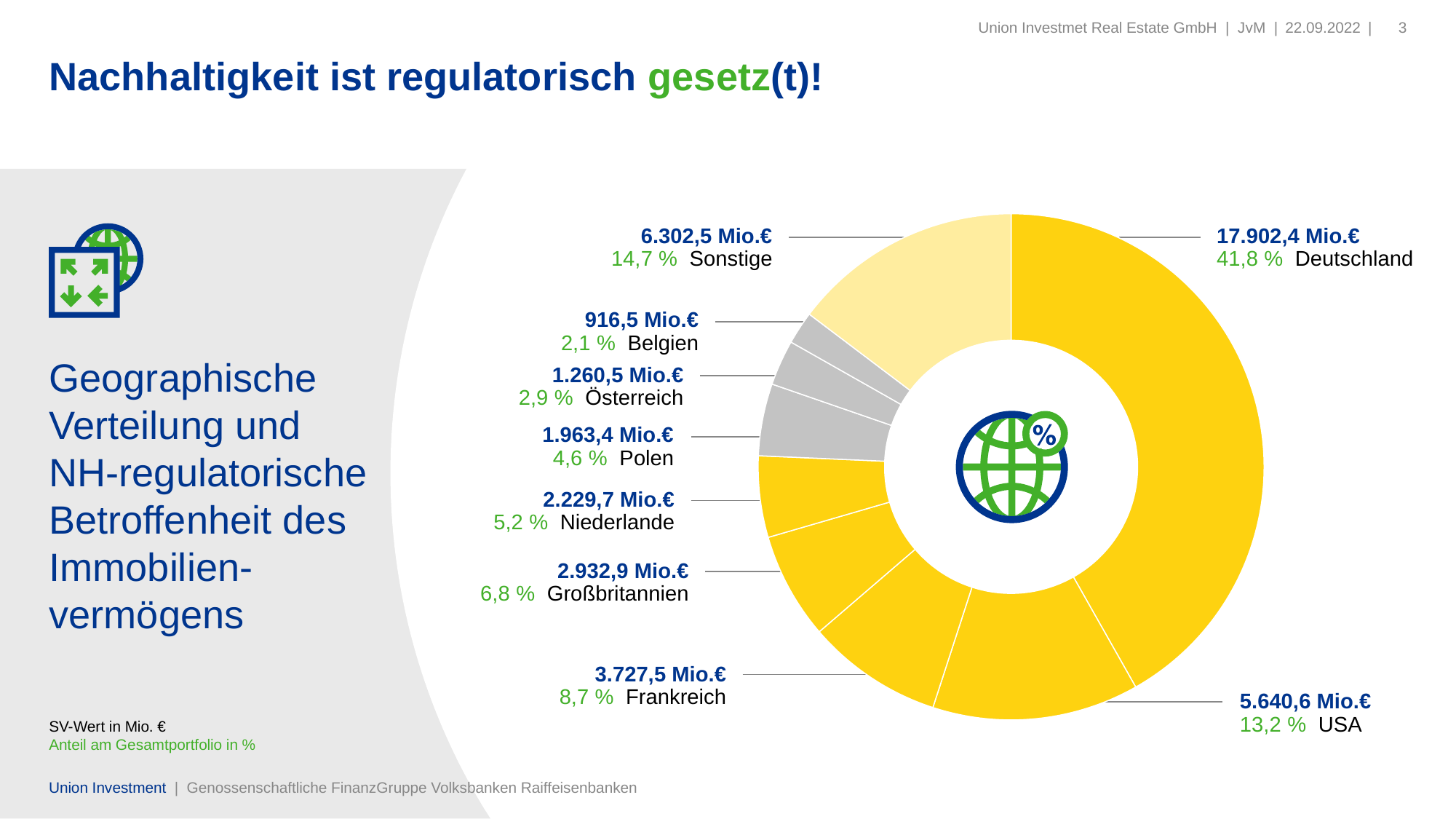
What share of the total portfolio does the USA account for? 13,2 % What is the SV-Wert for Deutschland? 17.902,4 Mio.€ What kind of chart is shown on the slide? Pie (donut) chart Which category has the smallest SV-Wert? Belgien What is the SV-Wert for Österreich? 1.260,5 Mio.€ What is the difference in SV-Wert between Frankreich and Großbritannien? 794,6 Mio.€ What is the SV-Wert for Frankreich? 3.727,5 Mio.€ Which category has the largest share of the portfolio? Deutschland What share of the total portfolio does Sonstige account for? 14,7 % Which has a larger SV-Wert, Polen or Niederlande? Niederlande What is the difference in SV-Wert between Deutschland and USA? 12.261,8 Mio.€ How many categories are shown in the chart? 9